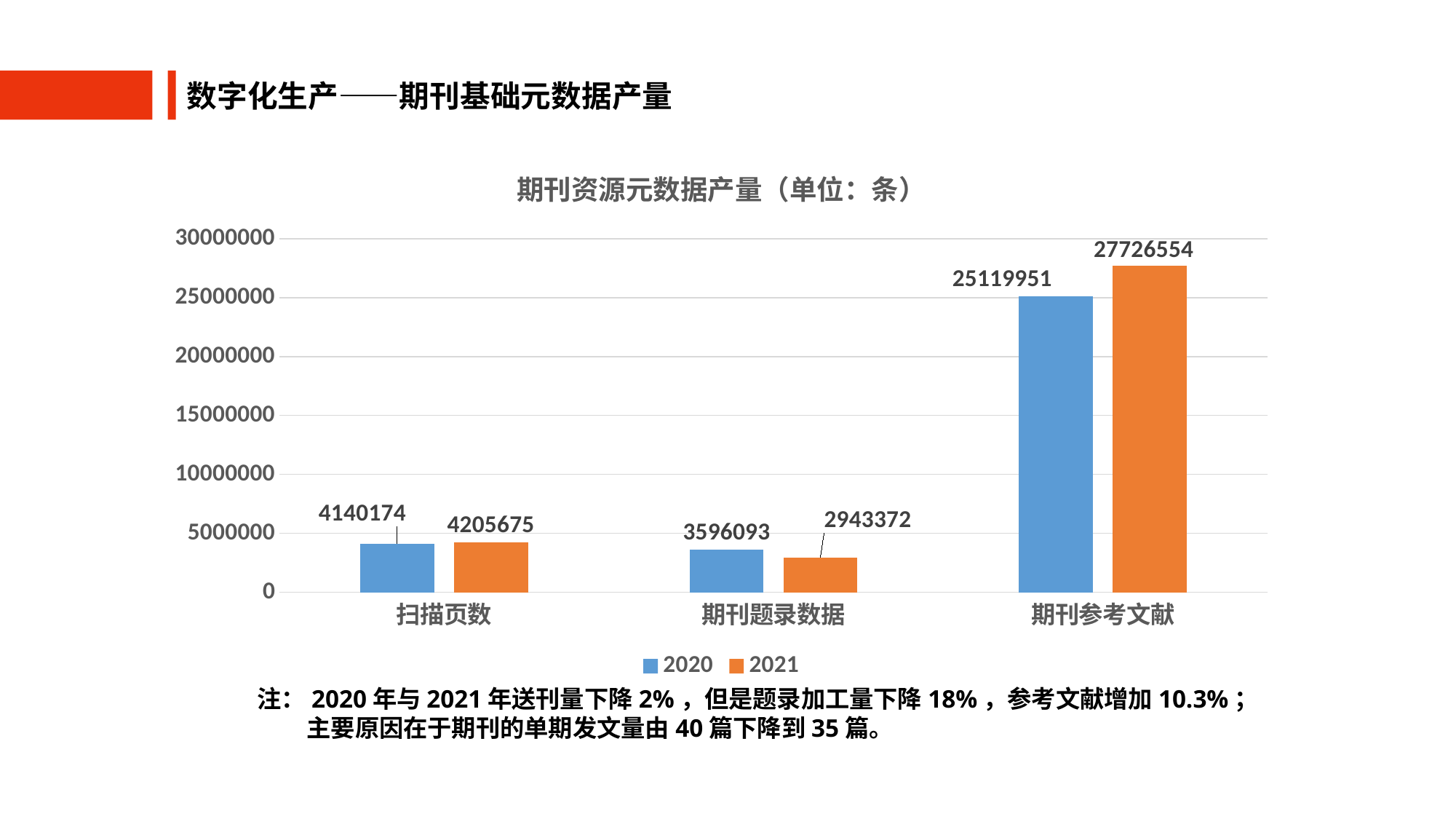
What is the title of the chart? 期刊资源元数据产量（单位：条） Which category has the lowest value in the 2020 series? 期刊题录数据 How many series does the legend list? 2 What is the 2020 value for 扫描页数? 4140174 What kind of chart is shown on the slide? bar chart What is the 2021 value for 期刊参考文献? 27726554 Which category has the highest value in the 2021 series? 期刊参考文献 Which is larger for 期刊题录数据: the 2020 value or the 2021 value? 2020 What is the difference between the 2021 and 2020 values for 期刊参考文献? 2606603 Is the 2020 value for 期刊参考文献 greater or less than 20000000? greater What is the 2021 value for 期刊题录数据? 2943372 How many categories are shown on the x axis? 3